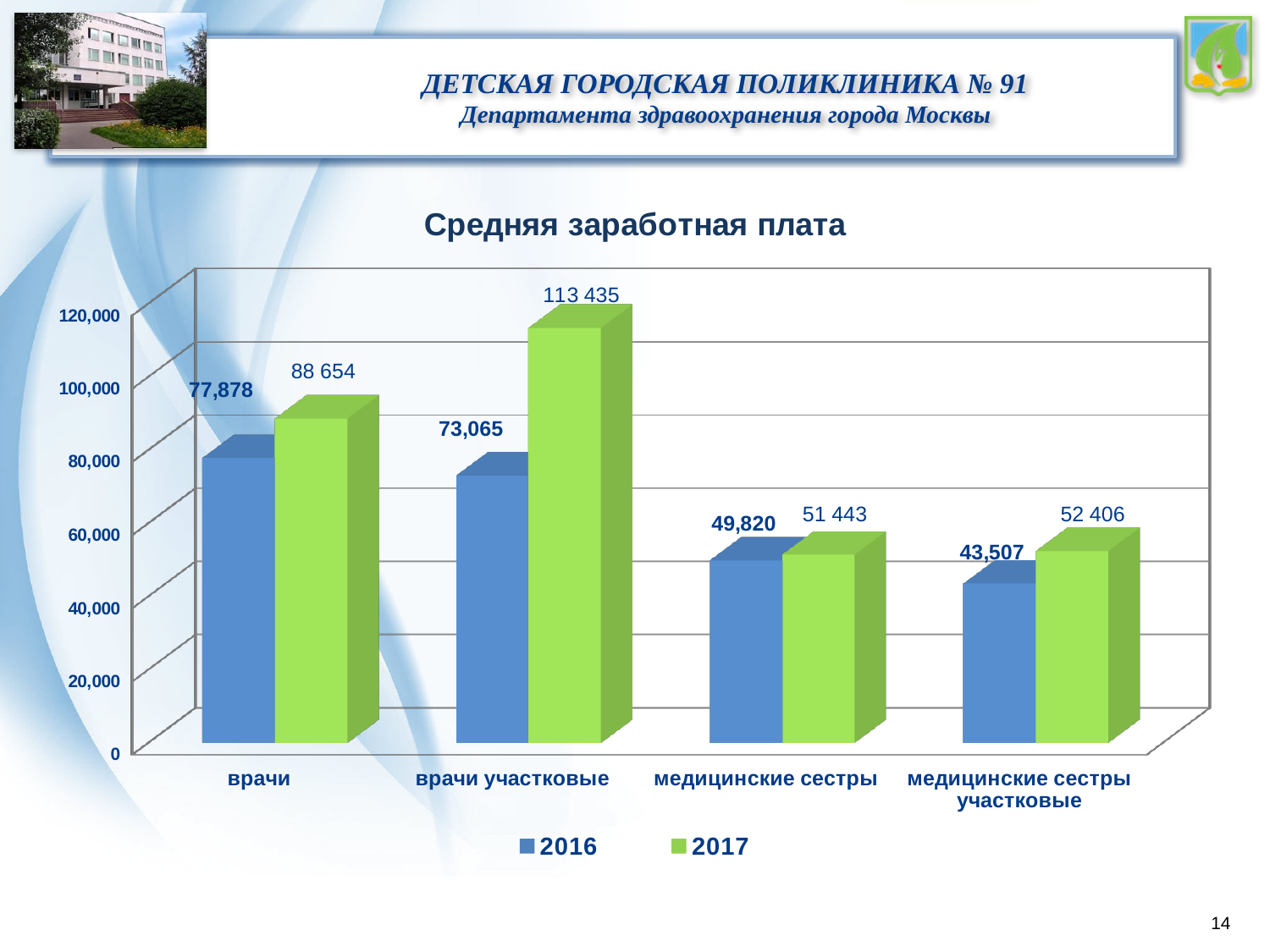
Which is larger for врачи: the 2016 value or the 2017 value? 2017 What is the value for медицинские сестры in 2017? 51 443 What is the title of the chart? Средняя заработная плата What is the difference between the 2017 and 2016 values for врачи участковые? 40,370 Which category has the highest value in 2017? врачи участковые How many series does the legend list? 2 What is the value for врачи in 2016? 77,878 What is the value for медицинские сестры участковые in 2016? 43,507 How many categories are shown on the x axis? 4 What is the value for врачи участковые in 2017? 113 435 Which category has the lowest value in 2016? медицинские сестры участковые What type of chart is shown on the slide? bar chart